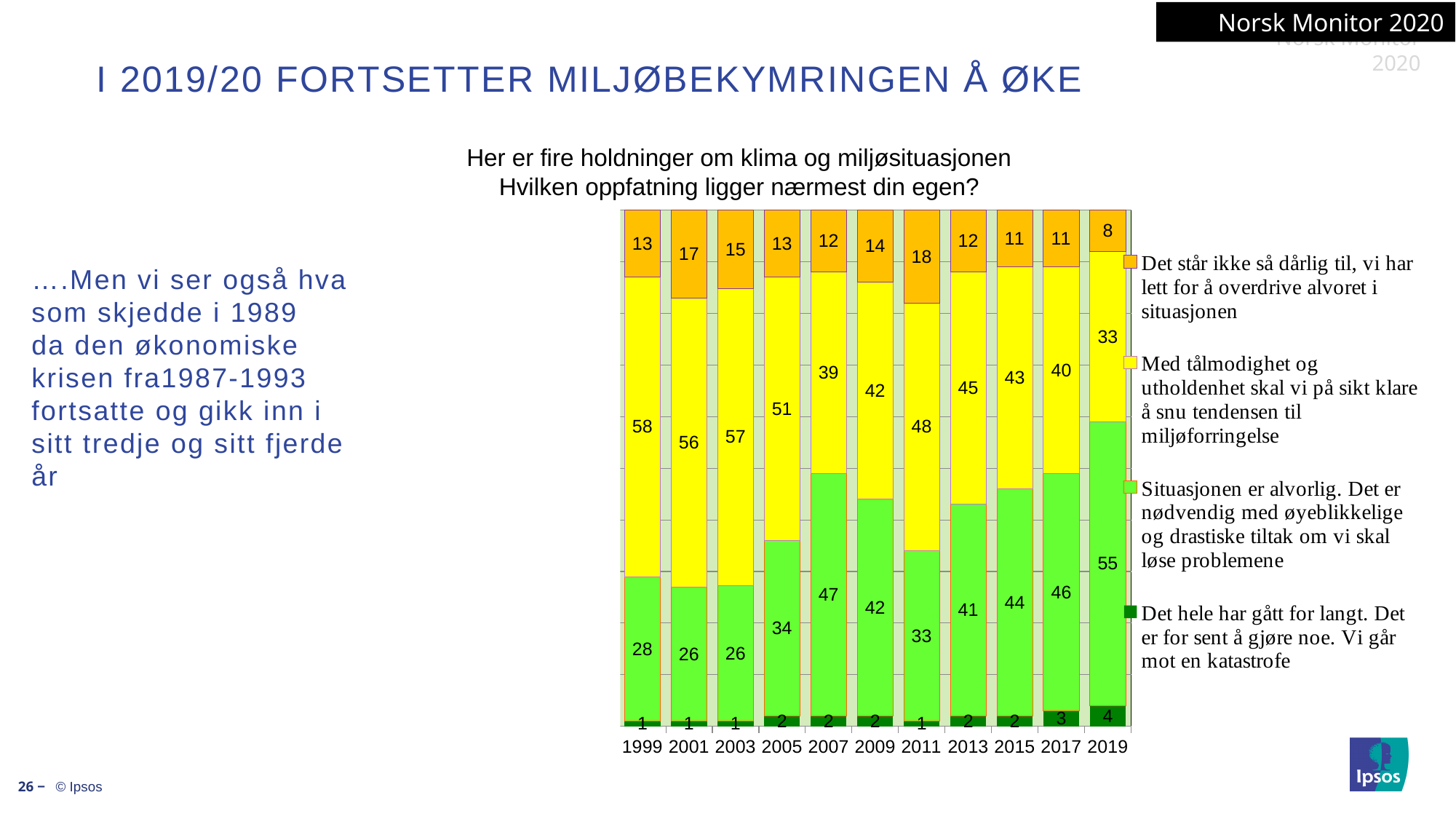
What is the value for 'Det står ikke så dårlig til' in 2011? 18 What is the value for 'Situasjonen er alvorlig' in 2019? 55 Which is larger in 2017: the value for 'Med tålmodighet og utholdenhet' or the value for 'Situasjonen er alvorlig'? Situasjonen er alvorlig How many years are shown along the x axis of the chart? 11 What is the value for 'Med tålmodighet og utholdenhet' in 1999? 58 What is the total of the stacked bar for 2019? 100 How many series does the chart's legend list? 4 What kind of chart is shown on the slide? Stacked bar chart In which year is the value for 'Situasjonen er alvorlig' highest? 2019 In which year is the value for 'Det står ikke så dårlig til' lowest? 2019 What is the difference between the 'Situasjonen er alvorlig' values in 2019 and 1999? 27 Does the value for 'Det hele har gått for langt' rise or fall from 1999 to 2019? Rise